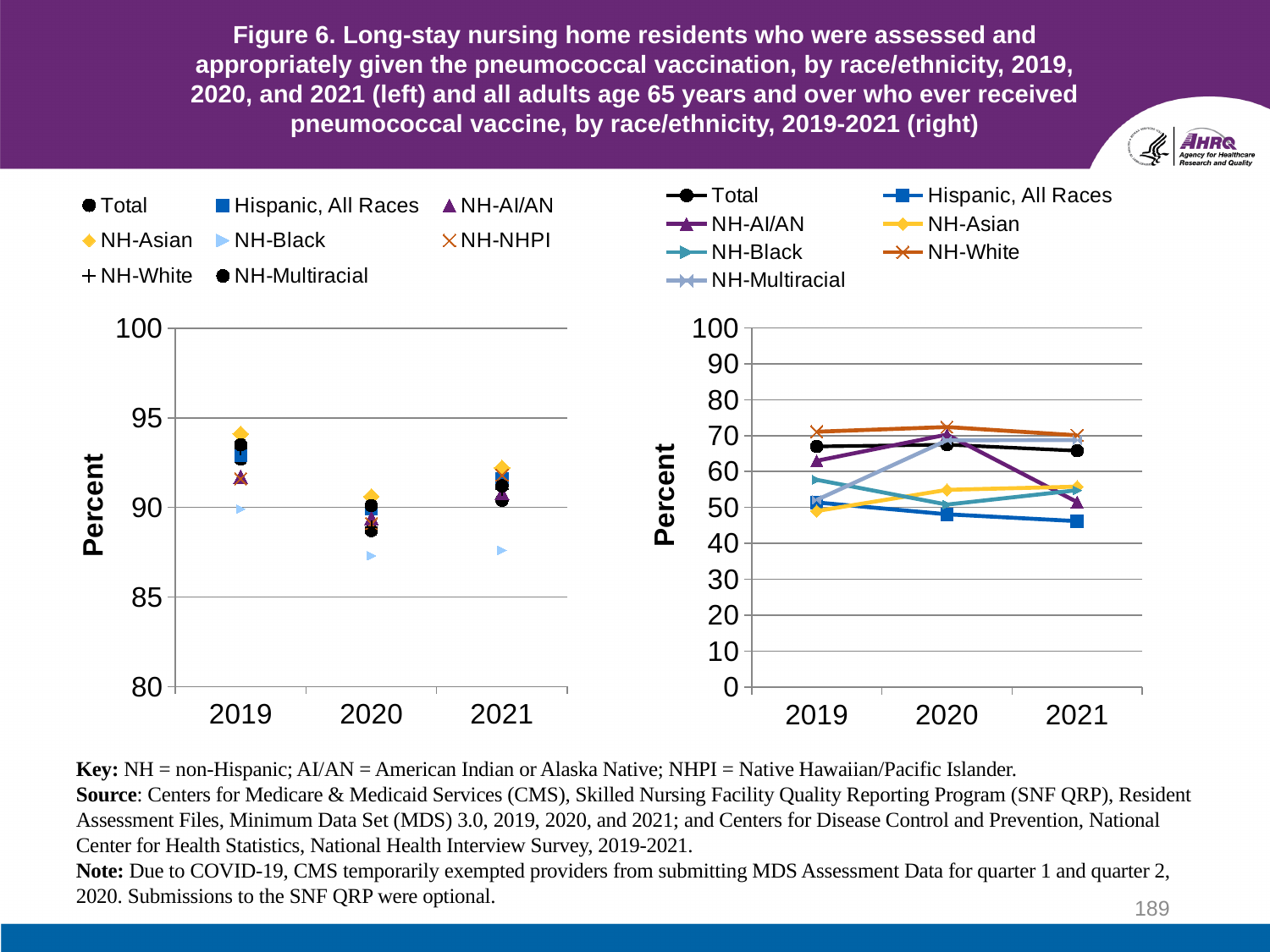
What kind of chart is the right chart? line chart On the right chart, is the value for NH-Black in 2019 greater or less than 50? greater On the left chart, is the value for NH-Asian in 2019 greater or less than 90? greater On the right chart, is the value for Hispanic, All Races in 2021 greater or less than 50? less On the right chart, does the value for Hispanic, All Races rise or fall from 2019 to 2021? fall On the left chart, which race/ethnicity group has the highest value in 2019? NH-Asian How many series does the legend of the right chart list? 7 On the right chart, which race/ethnicity group has the lowest value in 2021? Hispanic, All Races How many series does the legend of the left chart list? 8 On the left chart, which race/ethnicity group has the lowest value in 2020? NH-Black On the right chart, which race/ethnicity group has the highest value in 2021? NH-White